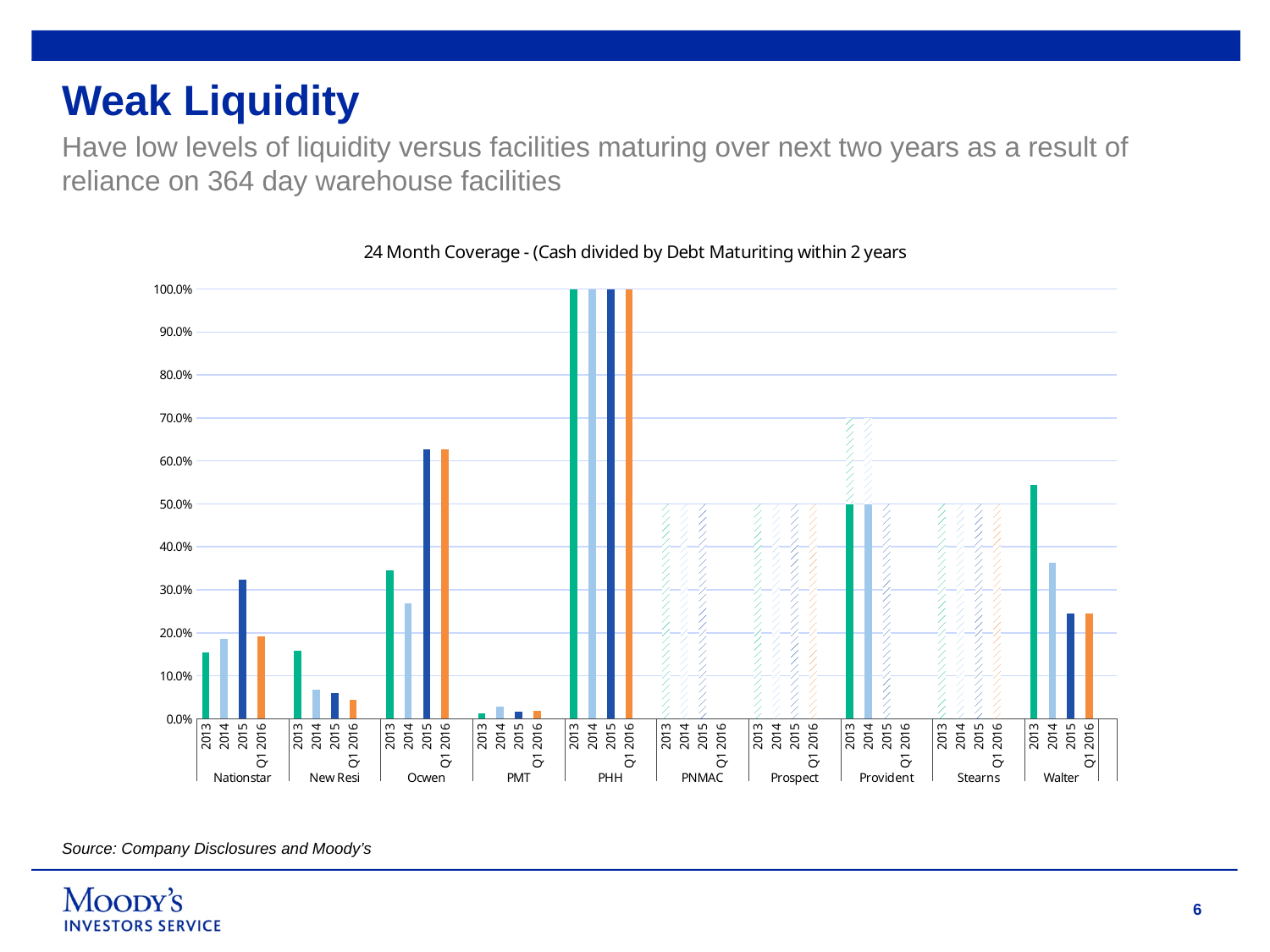
What kind of chart is shown on the slide? bar chart Is the 2013 value for New Resi greater or less than 20%? less How many companies are shown along the x axis of the chart? 10 Do the values for New Resi rise or fall from 2013 to Q1 2016? fall Which is larger, the 2015 value for Ocwen or the 2015 value for Nationstar? Ocwen How many time periods are plotted for each company? 4 Which company has the highest 24 month coverage in 2013? PHH What is the title of the chart? 24 Month Coverage - (Cash divided by Debt Maturiting within 2 years Is the 2015 value for Ocwen greater or less than 60%? greater